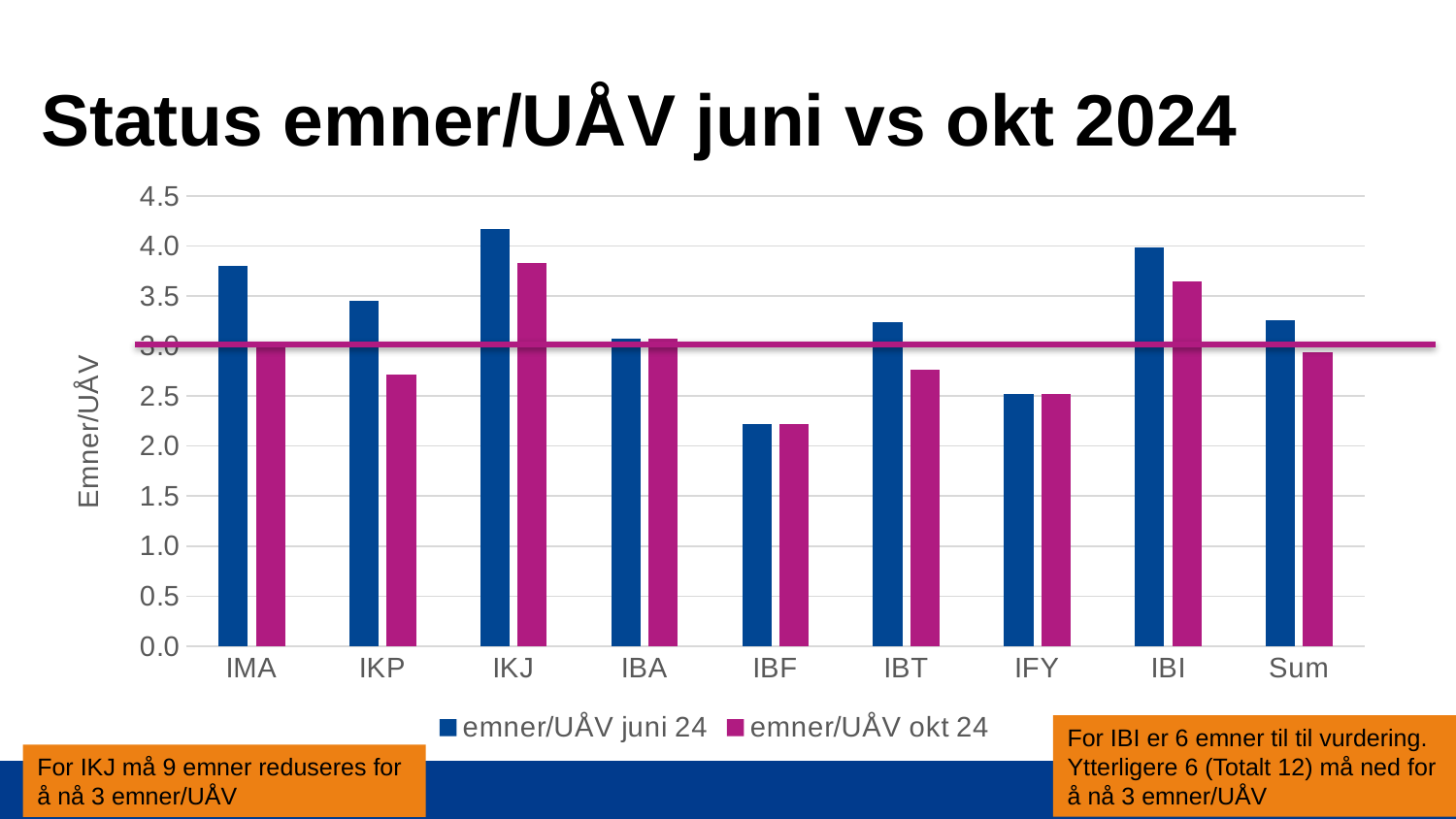
How many categories are shown along the x axis? 9 What is the label on the vertical axis? Emner/UÅV How many series does the legend list? 2 For IMA, which is larger: emner/UÅV juni 24 or emner/UÅV okt 24? emner/UÅV juni 24 Is the value for IKP in emner/UÅV okt 24 greater or less than 3.0? less Which category has the highest value for emner/UÅV juni 24? IKJ Is the value for IKJ in emner/UÅV juni 24 greater or less than 4.0? greater What kind of chart is shown on the slide? bar chart Which category has the highest value for emner/UÅV okt 24? IKJ Is the value for IBF in emner/UÅV okt 24 greater or less than 2.5? less Which category has the lowest value for emner/UÅV juni 24? IBF What is the title of the chart on the slide? Status emner/UÅV juni vs okt 2024